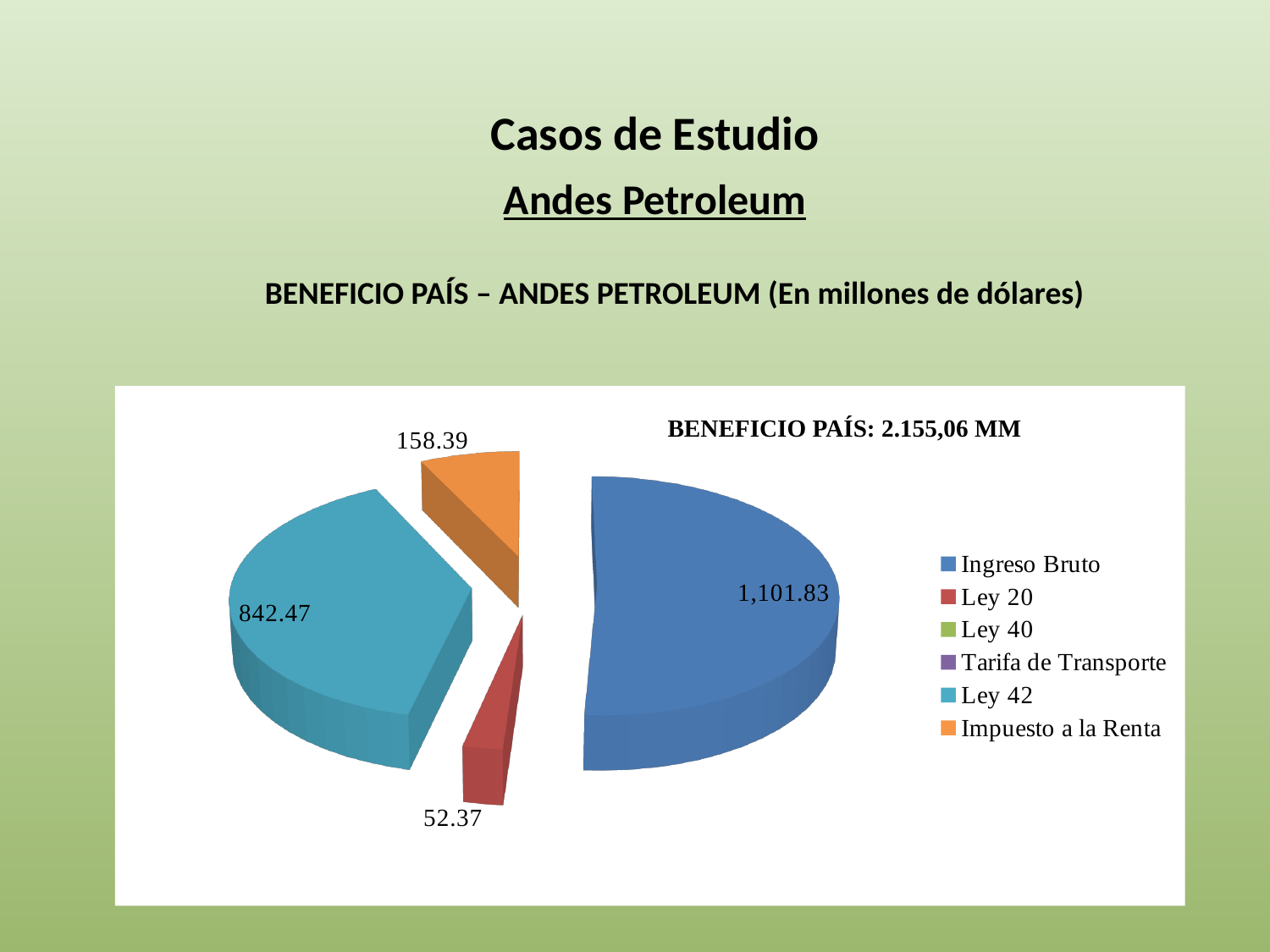
What is the value for Ingreso Bruto? 1,101.83 What is the value for Ley 42? 842.47 Which category has the largest slice of the pie? Ingreso Bruto Which labelled slice has the smallest value? Ley 20 What is the difference between the values for Ingreso Bruto and Ley 42? 259.36 What kind of chart is shown on the slide? pie chart How many entries does the legend list? 6 What is the difference between the values for Impuesto a la Renta and Ley 20? 106.02 What total Beneficio País is stated in the chart? 2.155,06 MM What is the value for Ley 20? 52.37 What is the value for Impuesto a la Renta? 158.39 Which is larger, the value for Ley 42 or the value for Impuesto a la Renta? Ley 42